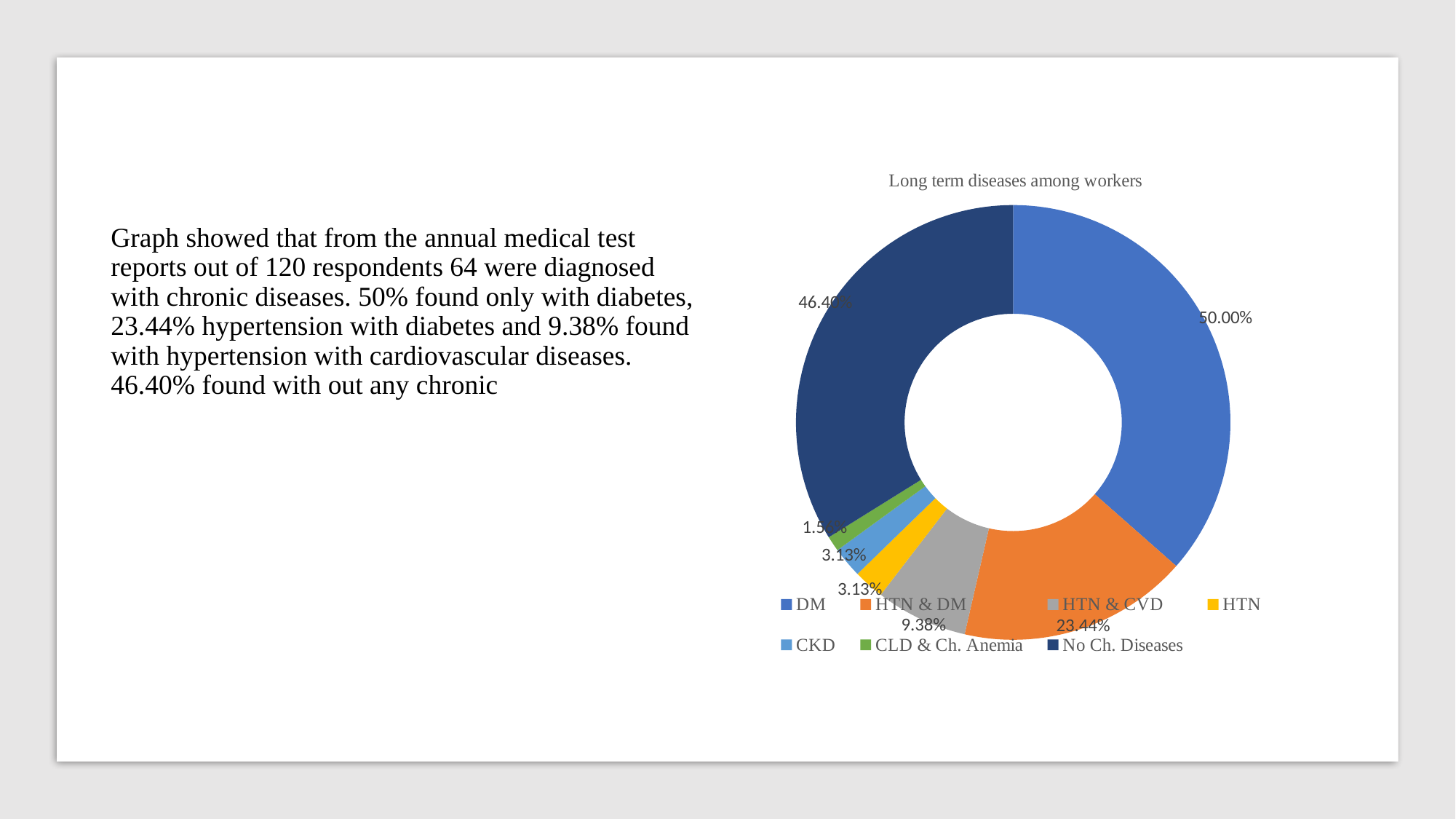
What percentage is shown for DM? 50.00% What kind of chart is shown on the slide? doughnut chart Which category has the smallest slice? CLD & Ch. Anemia What is the difference between the DM and HTN & DM percentages? 26.56% Which is larger, HTN & DM or No Ch. Diseases? No Ch. Diseases What percentage is shown for HTN? 3.13% How many categories does the legend list? 7 What percentage is shown for HTN & DM? 23.44% What percentage is shown for No Ch. Diseases? 46.40% What is the title of the chart? Long term diseases among workers Which category has the largest slice? DM What percentage is shown for HTN & CVD? 9.38%